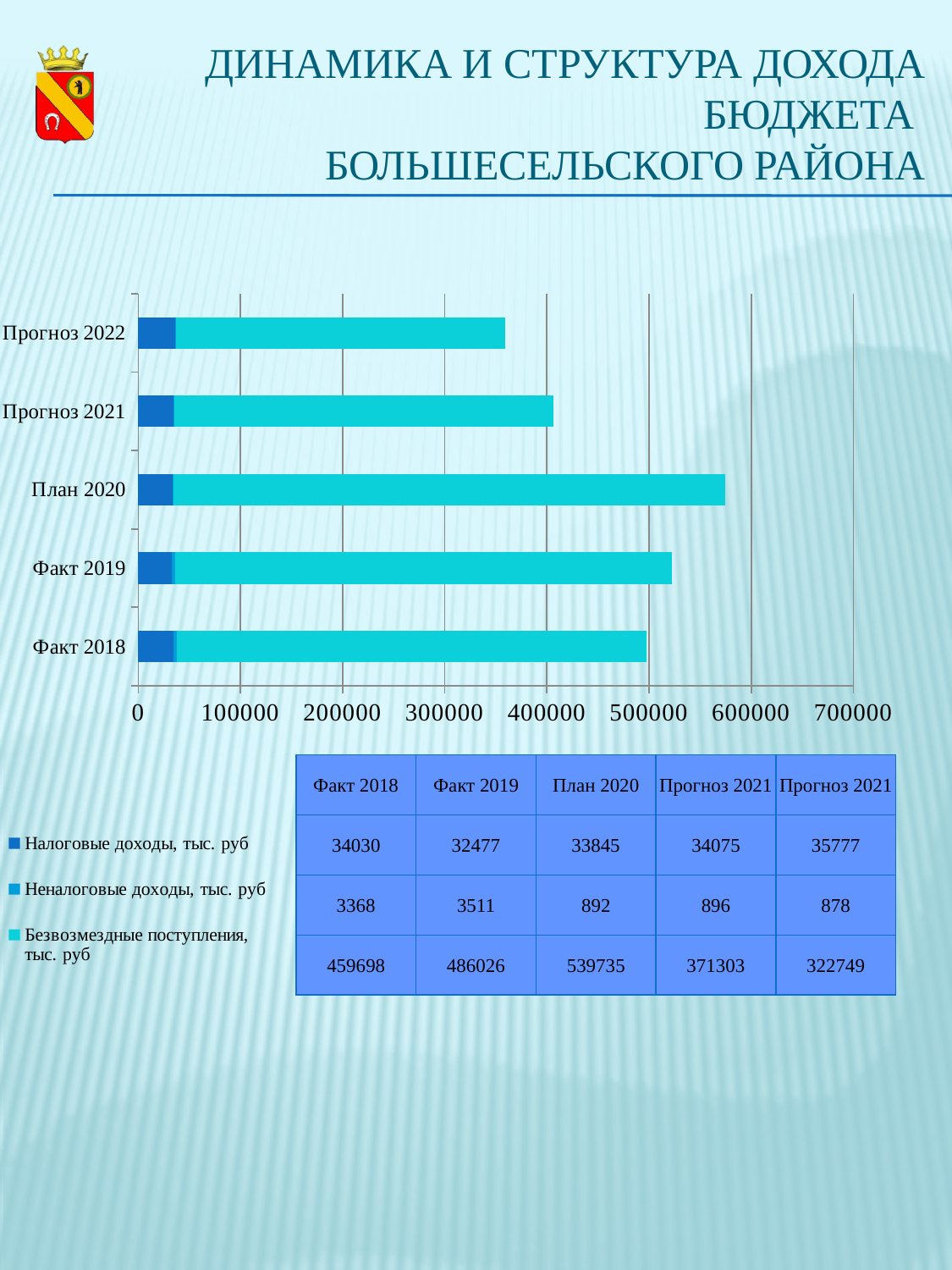
How many series does the legend list? 3 What kind of chart is shown on the slide? bar chart What is the difference in Безвозмездные поступления between План 2020 and Факт 2019? 53709 What is the total of the stacked bar for План 2020? 574472 Which category has the shortest total bar? Прогноз 2022 Which category has the longest total bar? План 2020 What is the value of Безвозмездные поступления for Факт 2019? 486026 Which total bar is longer, Факт 2018 or Факт 2019? Факт 2019 What is the value of Налоговые доходы for Факт 2018? 34030 How many categories (years) are plotted on the chart? 5 Is the total bar for Прогноз 2022 greater or less than 400000? less What is the value of Неналоговые доходы for План 2020? 892